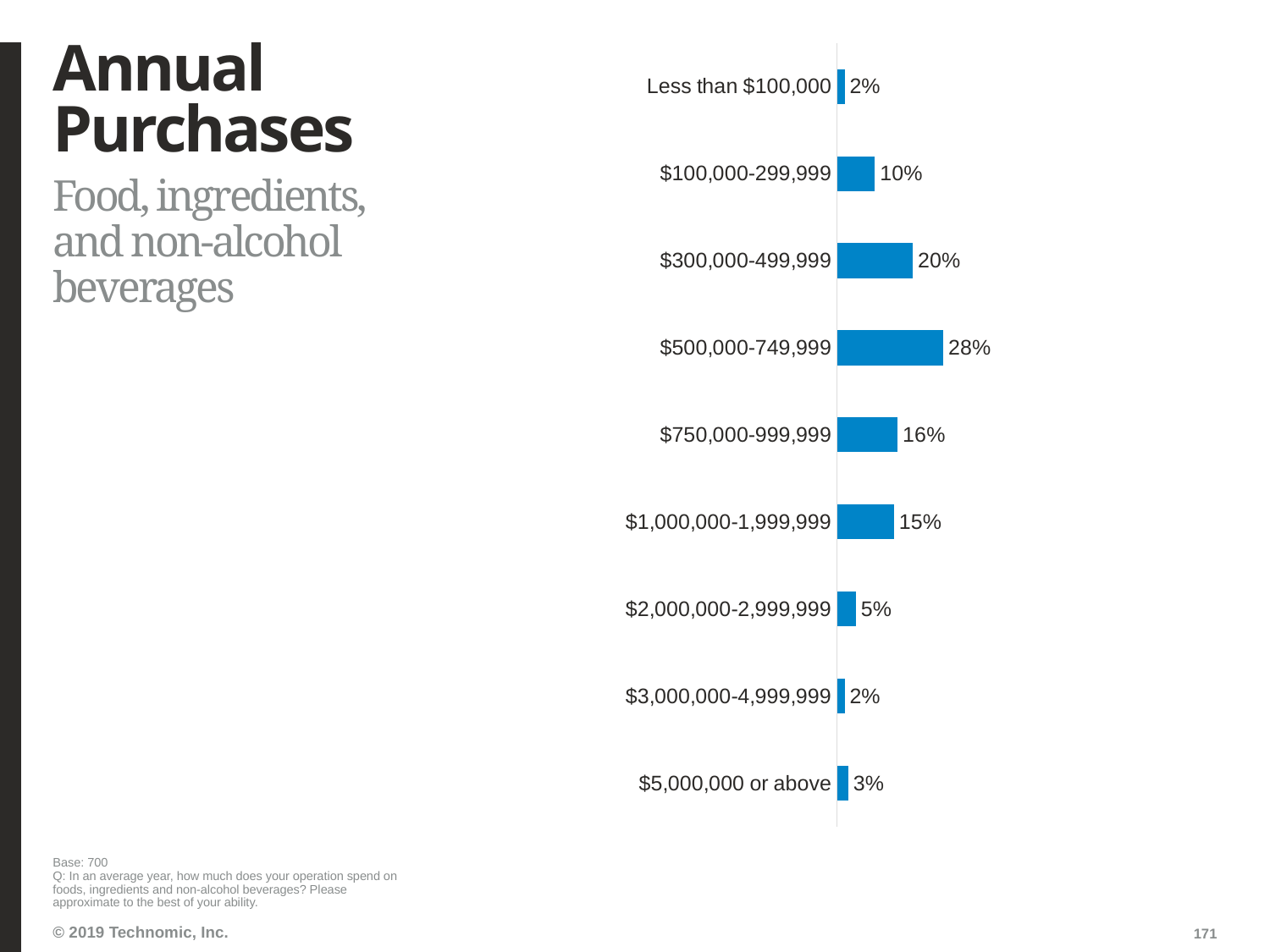
Which spending category has the highest percentage? $500,000-749,999 How many spending categories are shown in the chart? 9 What type of chart is shown on the slide? Bar chart What is the subtitle of the slide describing what the purchases cover? Food, ingredients, and non-alcohol beverages What is the value shown for the $5,000,000 or above category? 3% What is the difference between the values for $500,000-749,999 and $300,000-499,999? 8 percentage points What is the combined percentage for the $2,000,000-2,999,999 and $3,000,000-4,999,999 categories? 7% What percentage of operations spend $500,000-749,999 annually on food, ingredients and non-alcohol beverages? 28% What is the base (number of respondents) noted on the slide? 700 Which is larger: the value for $750,000-999,999 or the value for $1,000,000-1,999,999? $750,000-999,999 What is the value shown for the $100,000-299,999 category? 10%